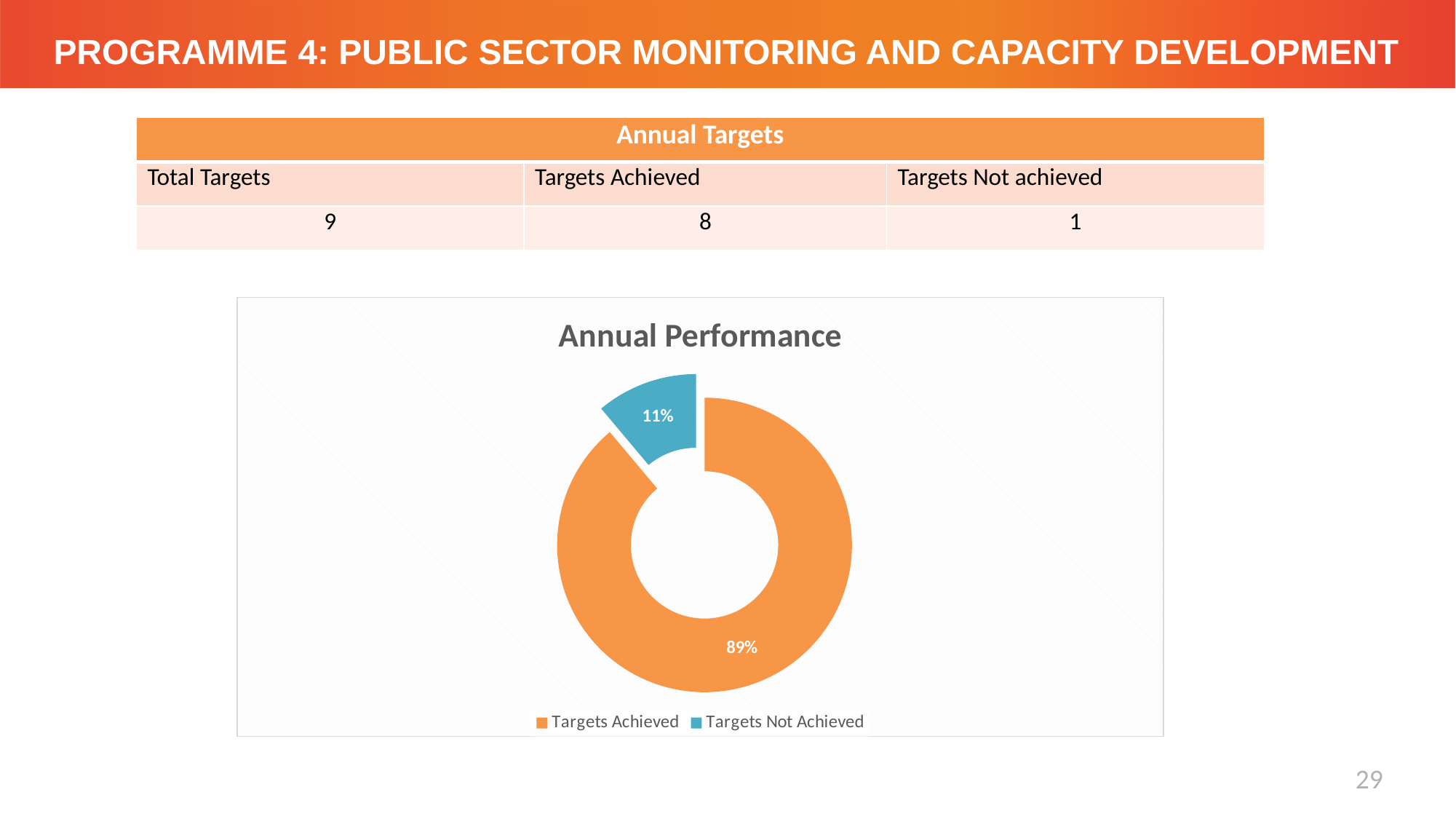
Which category has the smallest share of the chart? Targets Not Achieved What colour represents Targets Not Achieved in the chart? Blue What kind of chart is shown on the slide? Doughnut (pie) chart What is the difference in percentage points between Targets Achieved and Targets Not Achieved? 78 percentage points What is the title of the chart? Annual Performance What share of the chart does the Targets Achieved slice take? 89% What percentage is shown for Targets Achieved in the chart? 89% Which is larger in the chart, Targets Achieved or Targets Not Achieved? Targets Achieved What percentage is shown for Targets Not Achieved in the chart? 11% How many categories does the chart legend list? 2 Which category has the largest share of the chart? Targets Achieved